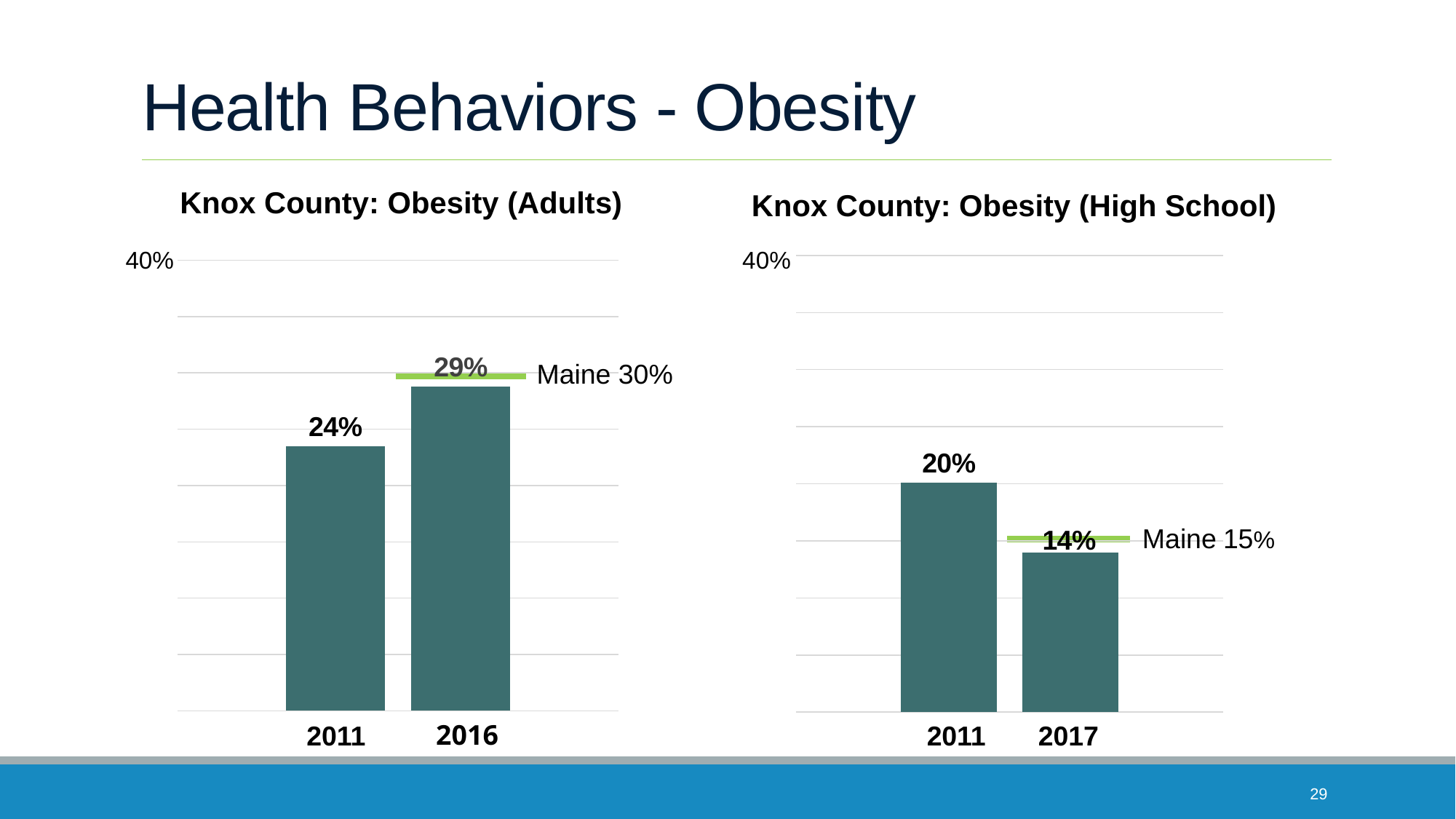
What kind of chart is the 'Knox County: Obesity (Adults)' chart? bar chart In the 'Knox County: Obesity (High School)' chart, do the values rise or fall from 2011 to 2017? fall In the 'Knox County: Obesity (Adults)' chart, what is the difference between the 2016 and 2011 values? 5% In the 'Knox County: Obesity (Adults)' chart, which year has the lower value? 2011 In the 'Knox County: Obesity (Adults)' chart, do the values rise or fall from 2011 to 2016? rise In the 'Knox County: Obesity (High School)' chart, what is the value for 2011? 20% In the 'Knox County: Obesity (High School)' chart, which year has the higher value? 2011 In the 'Knox County: Obesity (Adults)' chart, what is the value for 2011? 24% In the 'Knox County: Obesity (High School)' chart, what is the value for 2017? 14% In the 'Knox County: Obesity (High School)' chart, what is the difference between the 2011 and 2017 values? 6% In the 'Knox County: Obesity (Adults)' chart, what is the value for 2016? 29% In the 'Knox County: Obesity (Adults)' chart, what Maine value is marked by the green reference line? 30%